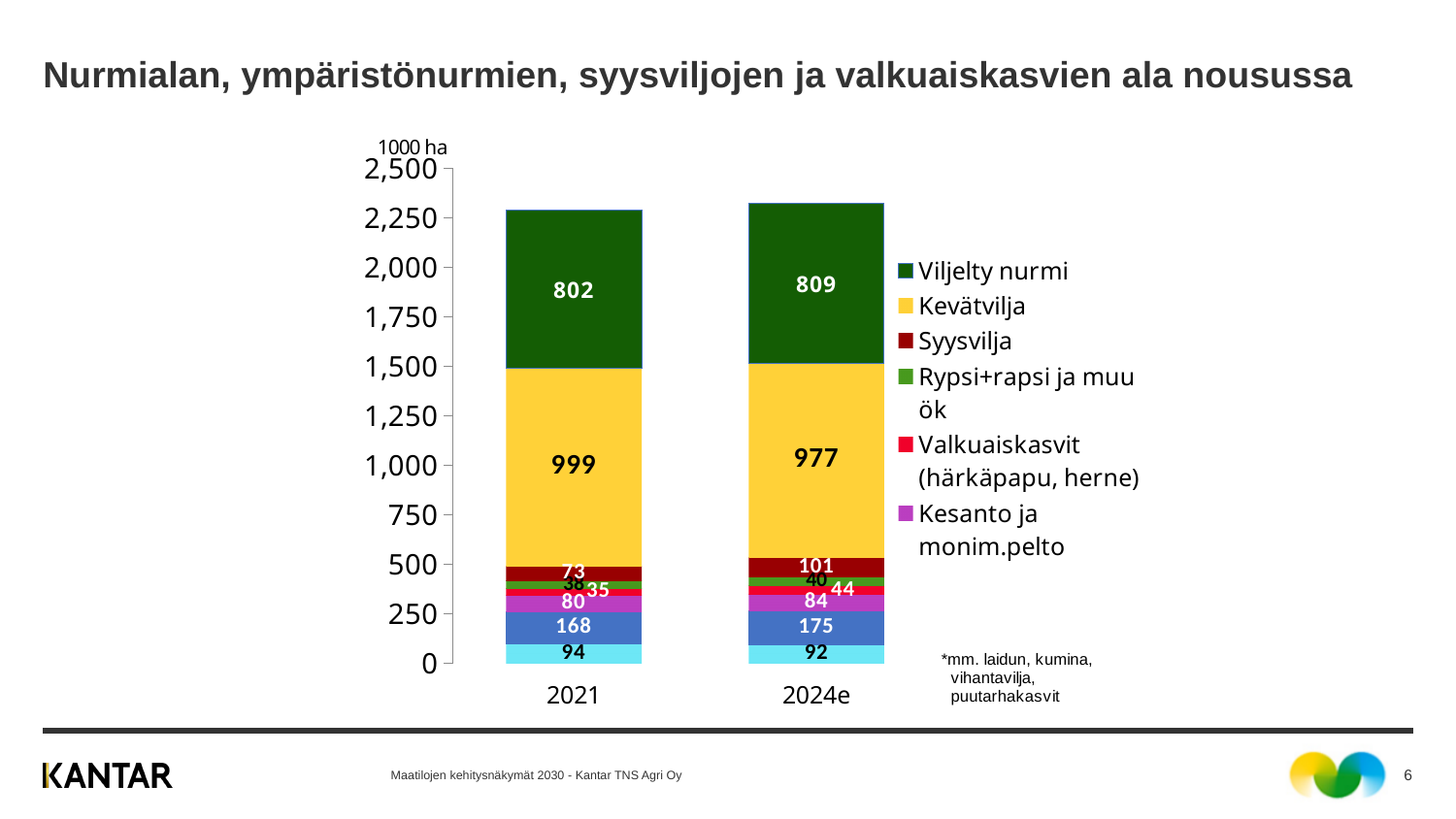
How many categories (years) are shown on the x axis? 2 What is the value for Valkuaiskasvit (härkäpapu, herne) in 2024e? 44 Which year has the larger Viljelty nurmi value, 2021 or 2024e? 2024e By how much does the Syysvilja value in 2024e exceed the Syysvilja value in 2021? 28 What is the value for Viljelty nurmi in 2021? 802 What is the value for Syysvilja in 2024e? 101 What is the value for Kesanto ja monim.pelto in 2021? 80 What kind of chart is shown on the slide? Stacked bar chart What is the difference between the Kevätvilja values for 2021 and 2024e? 22 What is the value for Kevätvilja in 2024e? 977 How many series does the legend list? 6 Which series has the largest segment in the 2021 bar? Kevätvilja